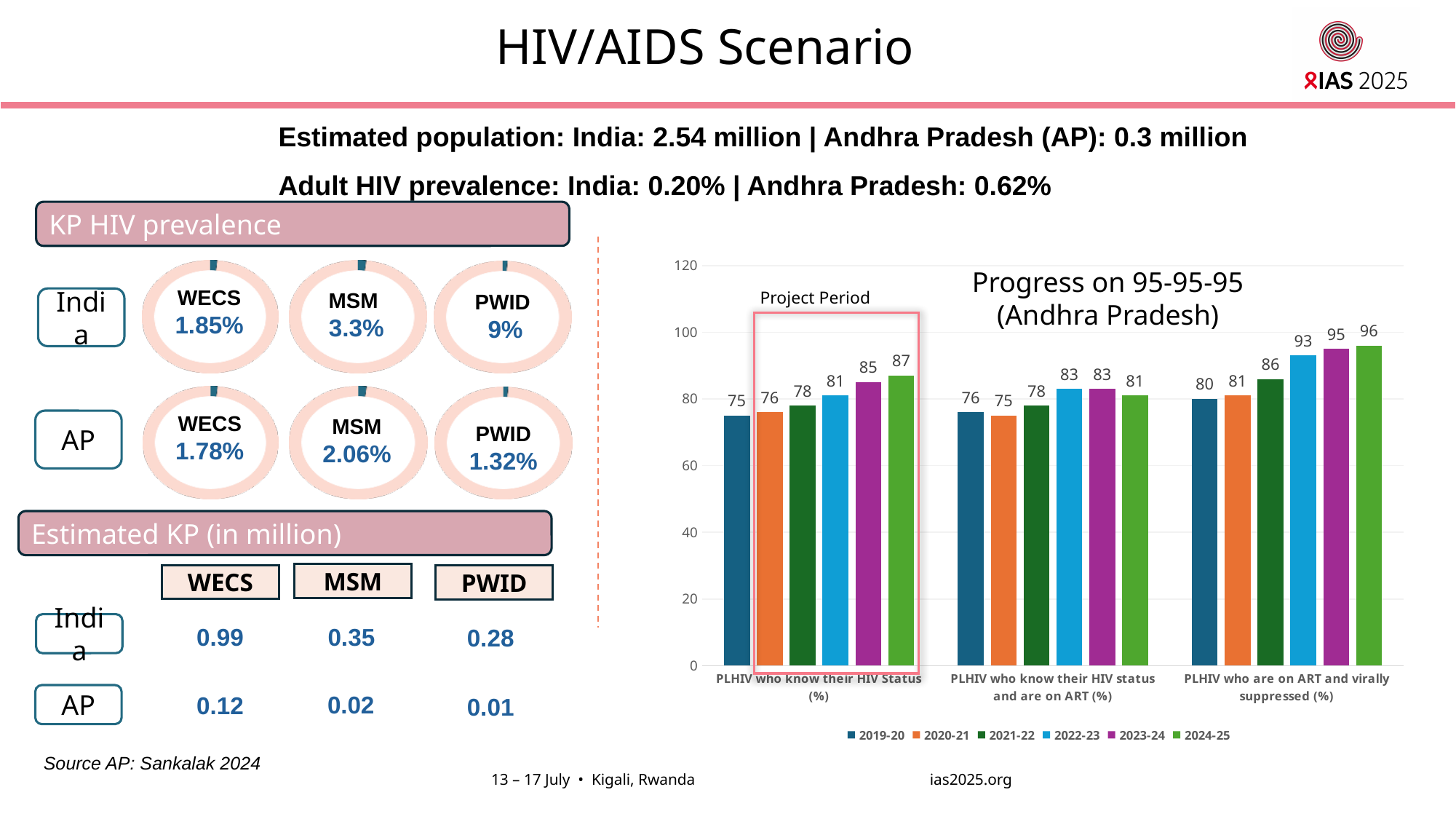
In the 'Progress on 95-95-95 (Andhra Pradesh)' chart, what is the value for 2022-23 for 'PLHIV who know their HIV status and are on ART (%)'? 83 In the 'Progress on 95-95-95 (Andhra Pradesh)' chart, which is larger for 2023-24: 'PLHIV who know their HIV Status (%)' or 'PLHIV who are on ART and virally suppressed (%)'? PLHIV who are on ART and virally suppressed (%) In the 'Progress on 95-95-95 (Andhra Pradesh)' chart, which year has the highest value for 'PLHIV who are on ART and virally suppressed (%)'? 2024-25 In the 'Progress on 95-95-95 (Andhra Pradesh)' chart, what is the value for 2024-25 for 'PLHIV who know their HIV Status (%)'? 87 How many categories are shown on the x axis of the 'Progress on 95-95-95 (Andhra Pradesh)' chart? 3 What kind of chart is 'Progress on 95-95-95 (Andhra Pradesh)'? Bar chart In the 'Progress on 95-95-95 (Andhra Pradesh)' chart, which year has the lowest value for 'PLHIV who know their HIV status and are on ART (%)'? 2020-21 How many series does the legend of the 'Progress on 95-95-95 (Andhra Pradesh)' chart list? 6 In the 'Progress on 95-95-95 (Andhra Pradesh)' chart, is the 2022-23 value for 'PLHIV who are on ART and virally suppressed (%)' greater or less than 80? greater In the 'Progress on 95-95-95 (Andhra Pradesh)' chart, do the values for 'PLHIV who are on ART and virally suppressed (%)' rise or fall from 2019-20 to 2024-25? Rise In the 'Progress on 95-95-95 (Andhra Pradesh)' chart, what is the value for 2019-20 for 'PLHIV who are on ART and virally suppressed (%)'? 80 In the 'Progress on 95-95-95 (Andhra Pradesh)' chart, what is the difference between the 2024-25 and 2019-20 values for 'PLHIV who know their HIV Status (%)'? 12